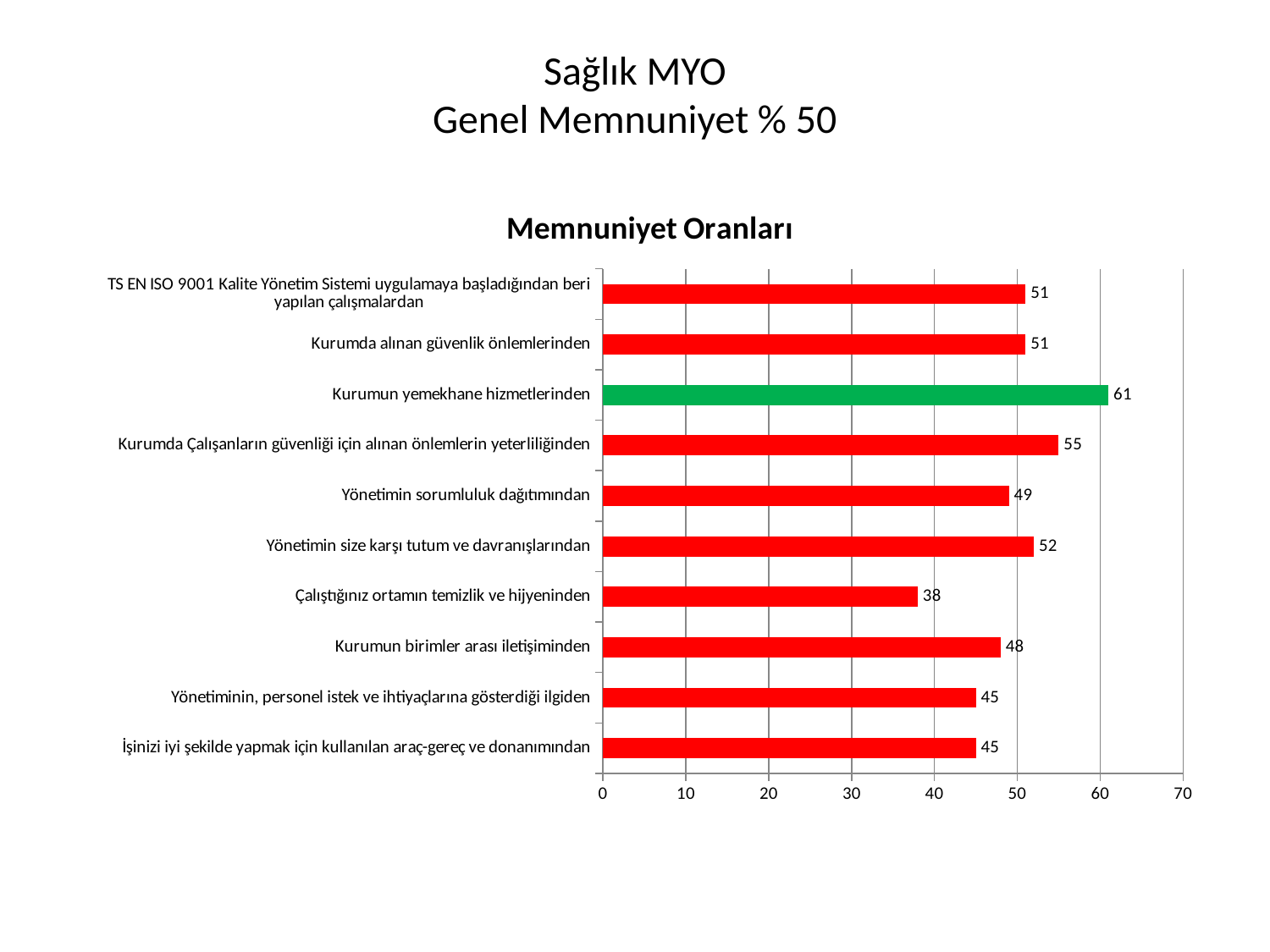
What is the title of the chart? Memnuniyet Oranları What kind of chart is shown on the slide? bar chart Which category has the highest value? Kurumun yemekhane hizmetlerinden What is the value for "Kurumun yemekhane hizmetlerinden"? 61 Is the value for "Kurumda alınan güvenlik önlemlerinden" greater or less than 40? greater What is the value for "Yönetimin sorumluluk dağıtımından"? 49 What is the difference between the values for "Kurumda Çalışanların güvenliği için alınan önlemlerin yeterliliğinden" and "Kurumun birimler arası iletişiminden"? 7 Which category has the lowest value? Çalıştığınız ortamın temizlik ve hijyeninden How many categories are shown in the chart? 10 What is the difference between the values for "Kurumun yemekhane hizmetlerinden" and "Çalıştığınız ortamın temizlik ve hijyeninden"? 23 What is the value for "Çalıştığınız ortamın temizlik ve hijyeninden"? 38 Which is larger: the value for "Yönetimin size karşı tutum ve davranışlarından" or the value for "Yönetiminin, personel istek ve ihtiyaçlarına gösterdiği ilgiden"? Yönetimin size karşı tutum ve davranışlarından